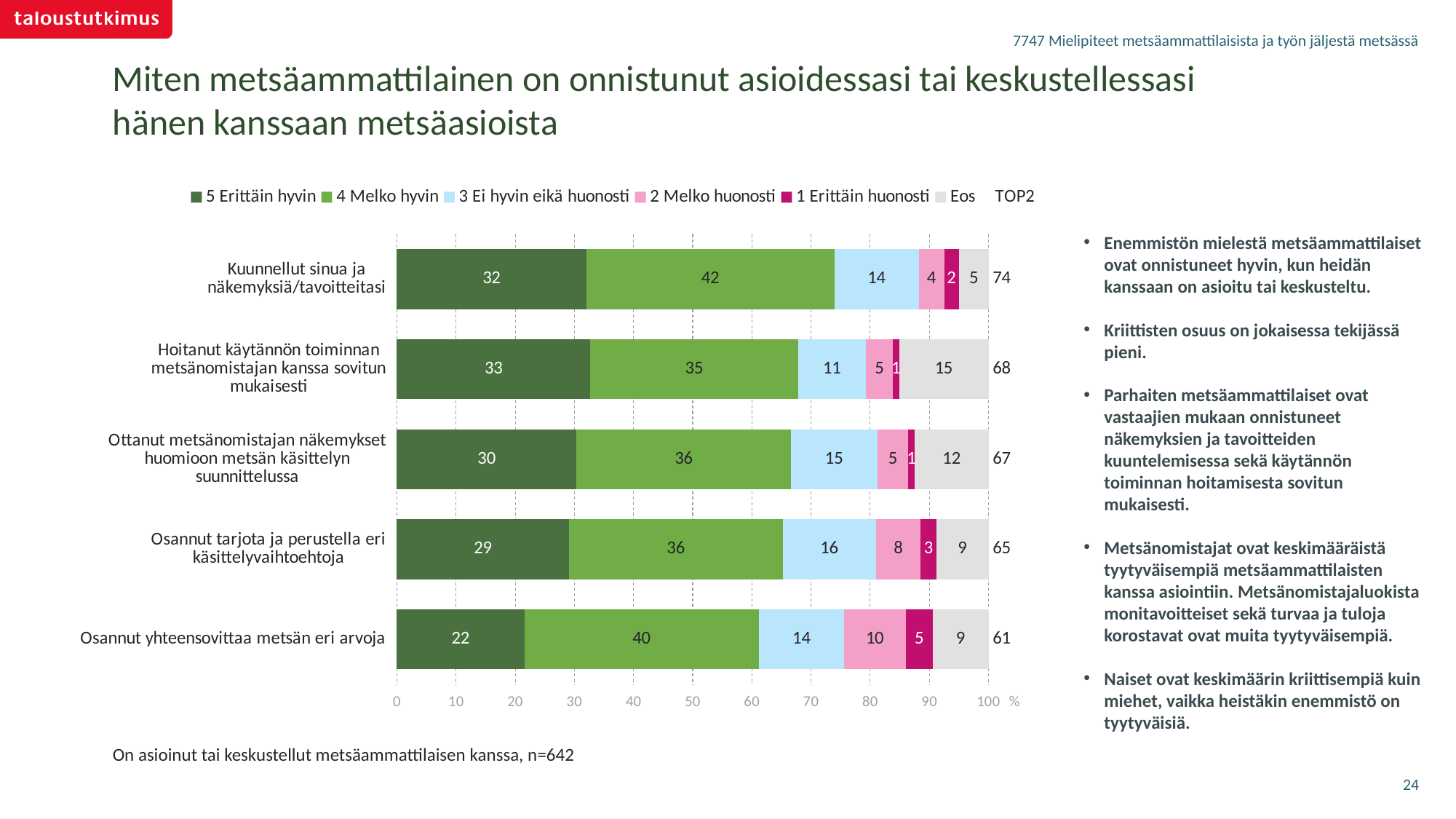
What kind of chart is shown on the slide? Stacked bar chart Which category has the highest "Eos" value? Hoitanut käytännön toiminnan metsänomistajan kanssa sovitun mukaisesti What sample size is stated below the chart? n=642 What is the value of "5 Erittäin hyvin" for "Kuunnellut sinua ja näkemyksiä/tavoitteitasi"? 32 How many categories are shown on the chart? 5 What is the value of "1 Erittäin huonosti" for "Osannut tarjota ja perustella eri käsittelyvaihtoehtoja"? 3 What is the TOP2 value for "Hoitanut käytännön toiminnan metsänomistajan kanssa sovitun mukaisesti"? 68 Which has a larger "Eos" value: "Hoitanut käytännön toiminnan metsänomistajan kanssa sovitun mukaisesti" or "Ottanut metsänomistajan näkemykset huomioon metsän käsittelyn suunnittelussa"? Hoitanut käytännön toiminnan metsänomistajan kanssa sovitun mukaisesti Which category has the lowest value for "5 Erittäin hyvin"? Osannut yhteensovittaa metsän eri arvoja What is the value of "4 Melko hyvin" for "Osannut yhteensovittaa metsän eri arvoja"? 40 Which category has the highest TOP2 value? Kuunnellut sinua ja näkemyksiä/tavoitteitasi What is the difference between the TOP2 values of "Kuunnellut sinua ja näkemyksiä/tavoitteitasi" and "Osannut yhteensovittaa metsän eri arvoja"? 13